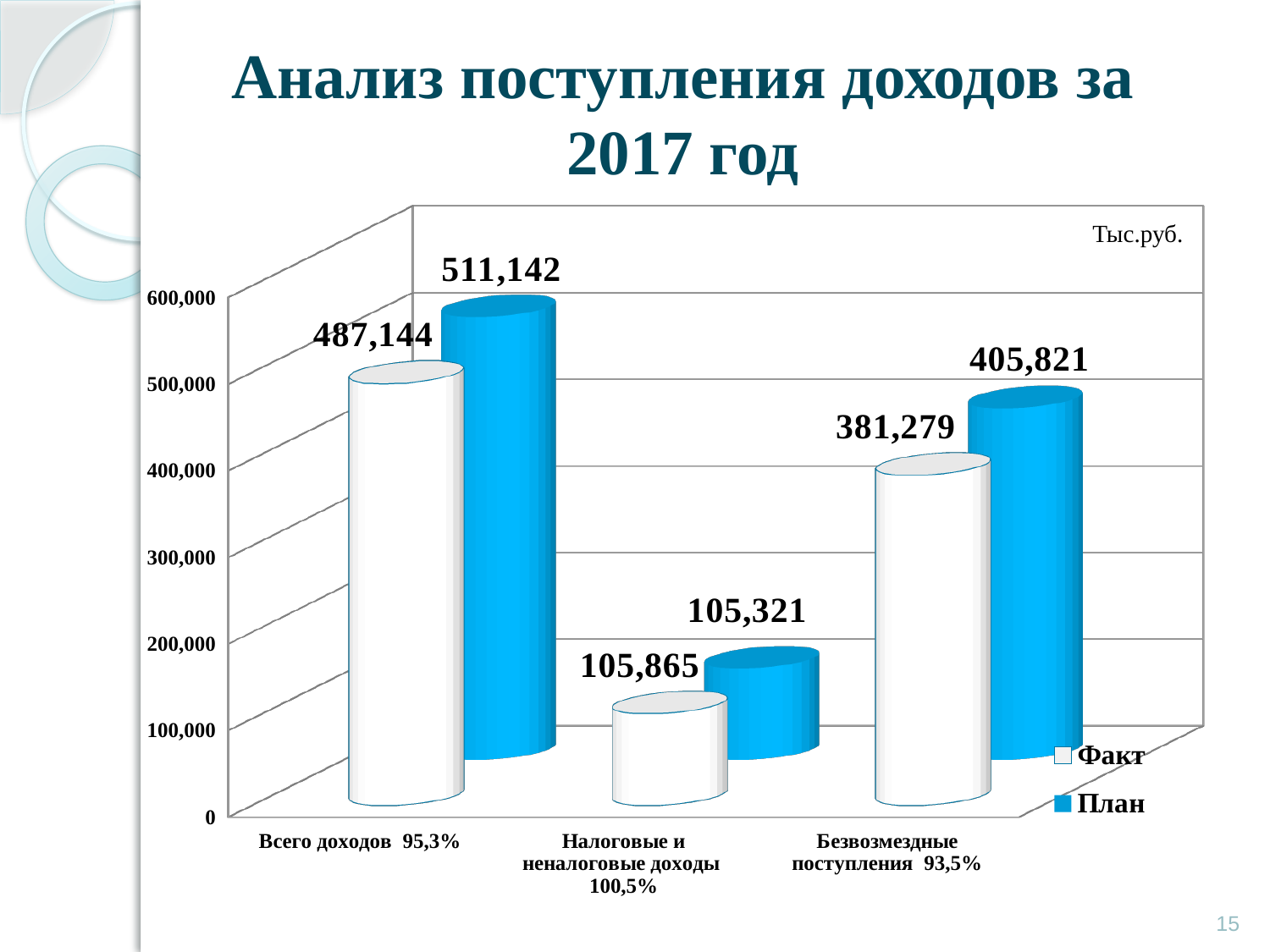
What is the difference between the План and Факт values for Всего доходов? 23,998 What unit is indicated for the values in the chart? Тыс.руб. What is the План value for Безвозмездные поступления? 405,821 What is the План value for Всего доходов? 511,142 What is the Факт value for Всего доходов? 487,144 What is the difference between the План and Факт values for Безвозмездные поступления? 24,542 Which is larger for Налоговые и неналоговые доходы, the Факт value or the План value? Факт How many series does the legend list? 2 Which category has the lowest План value? Налоговые и неналоговые доходы Which category has the highest Факт value? Всего доходов What is the Факт value for Налоговые и неналоговые доходы? 105,865 How many categories are shown on the x axis? 3